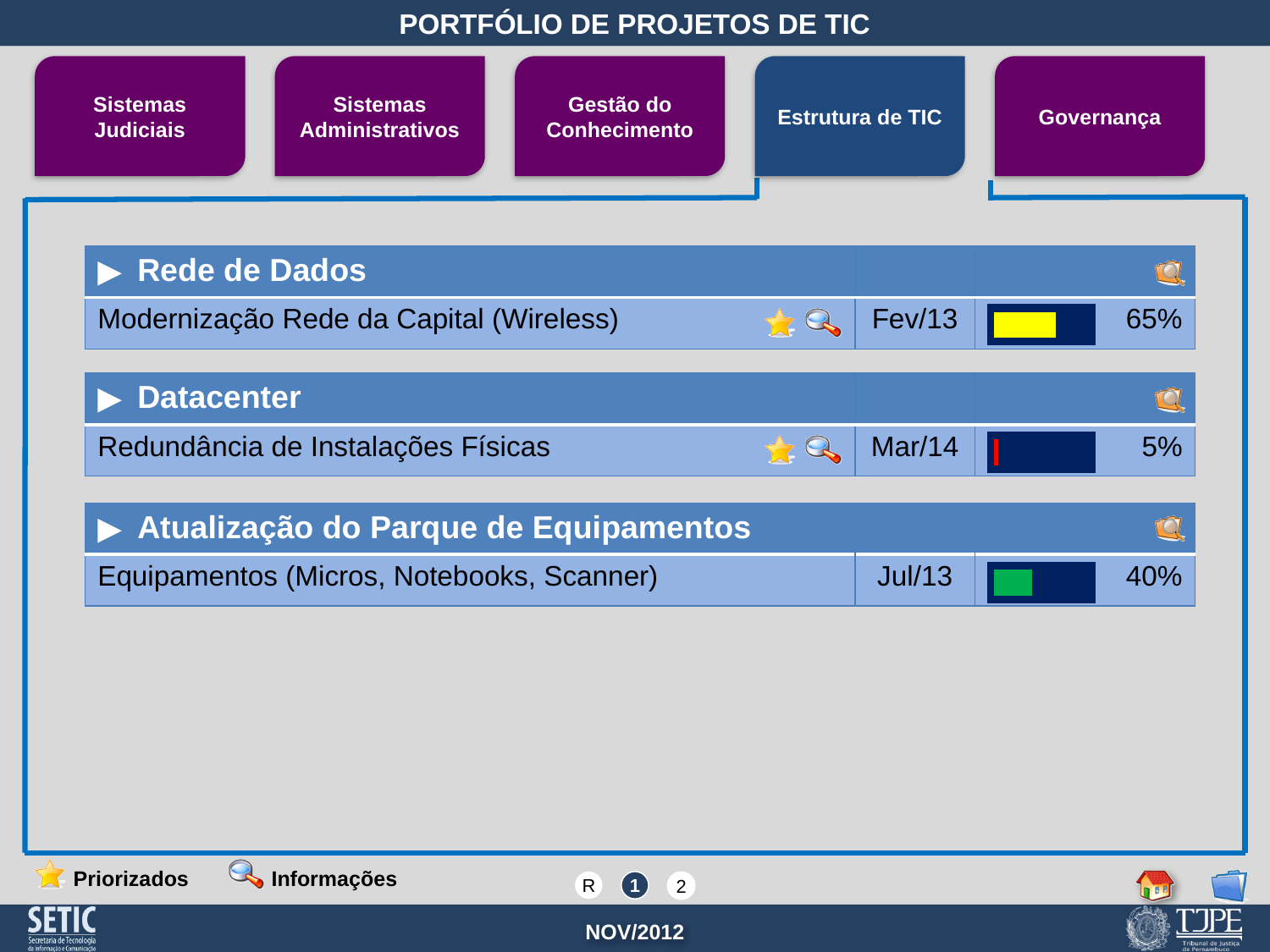
What completion percentage is shown for Equipamentos (Micros, Notebooks, Scanner)? 40% Which project has the lowest completion percentage? Redundância de Instalações Físicas What date is shown next to the Redundância de Instalações Físicas project? Mar/14 What completion percentage is shown for Modernização Rede da Capital (Wireless)? 65% What is the difference in completion percentage between Modernização Rede da Capital (Wireless) and Equipamentos (Micros, Notebooks, Scanner)? 25% What colour is the progress bar fill for Modernização Rede da Capital (Wireless)? Yellow What colour is the progress bar fill for Equipamentos (Micros, Notebooks, Scanner)? Green What is the difference in completion percentage between Equipamentos (Micros, Notebooks, Scanner) and Redundância de Instalações Físicas? 35% How many projects with progress bars are listed on the slide? 3 What completion percentage is shown for Redundância de Instalações Físicas? 5% Which has a higher completion percentage, Redundância de Instalações Físicas or Equipamentos (Micros, Notebooks, Scanner)? Equipamentos (Micros, Notebooks, Scanner) Which project has the highest completion percentage? Modernização Rede da Capital (Wireless)